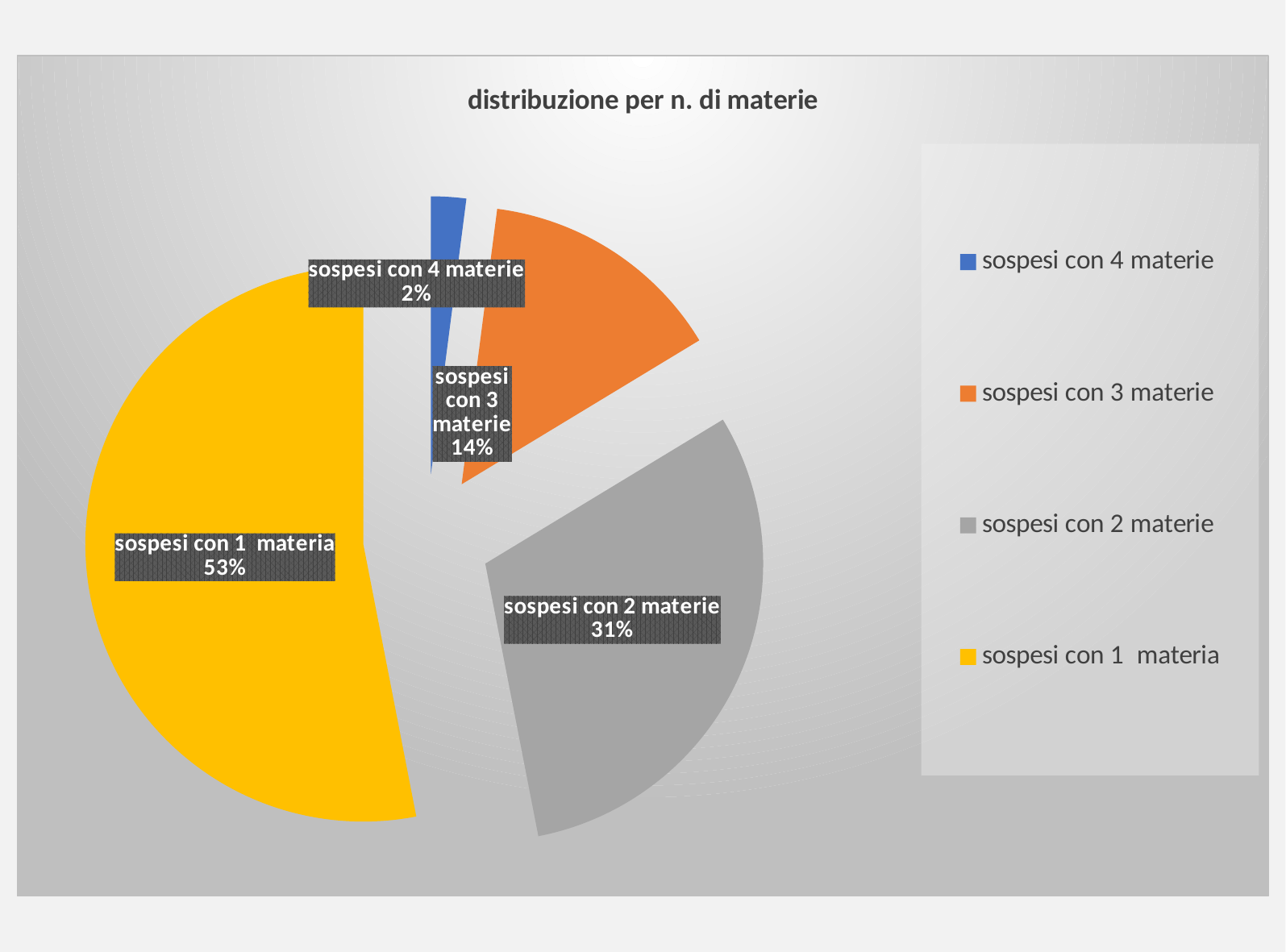
Which is larger: the share for 'sospesi con 3 materie' or 'sospesi con 2 materie'? sospesi con 2 materie What share of the pie is 'sospesi con 2 materie'? 31% What share of the pie is 'sospesi con 1 materia'? 53% What share of the pie is 'sospesi con 3 materie'? 14% How many slices does the pie chart have? 4 What colour is the slice for 'sospesi con 3 materie'? orange What is the title of the chart? distribuzione per n. di materie Which category has the largest slice of the pie? sospesi con 1 materia What is the difference in percentage points between 'sospesi con 1 materia' and 'sospesi con 2 materie'? 22 Which category has the smallest slice of the pie? sospesi con 4 materie What kind of chart is shown on the slide? pie chart